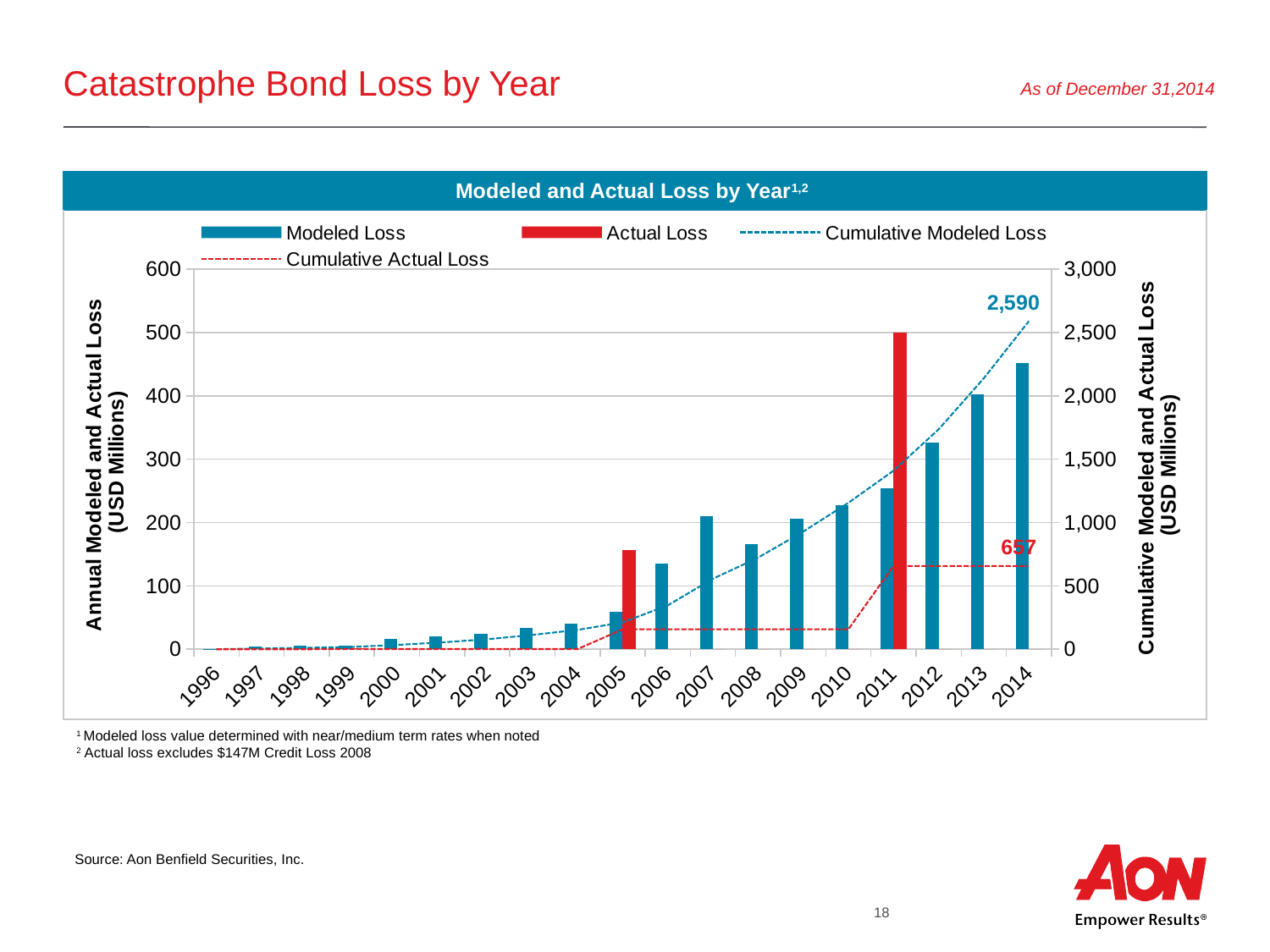
Is the Modeled Loss value for 2014 greater or less than 400? greater What is the labelled value of the Cumulative Actual Loss in 2014? 657 What colour are the Actual Loss bars in the chart? red What is the labelled value of the Cumulative Modeled Loss in 2014? 2,590 How many series does the legend of the 'Modeled and Actual Loss by Year' chart list? 4 In 2011, which is larger: the Modeled Loss or the Actual Loss? Actual Loss Is the Actual Loss value for 2011 greater or less than 400? greater Which year has the highest Modeled Loss bar? 2014 How many years are shown on the x axis of the 'Modeled and Actual Loss by Year' chart? 19 Which year has the highest Actual Loss bar? 2011 What is the difference between the labelled Cumulative Modeled Loss (2,590) and Cumulative Actual Loss (657) in 2014? 1,933 What kind of chart is shown under the title 'Modeled and Actual Loss by Year'? combination bar and line chart